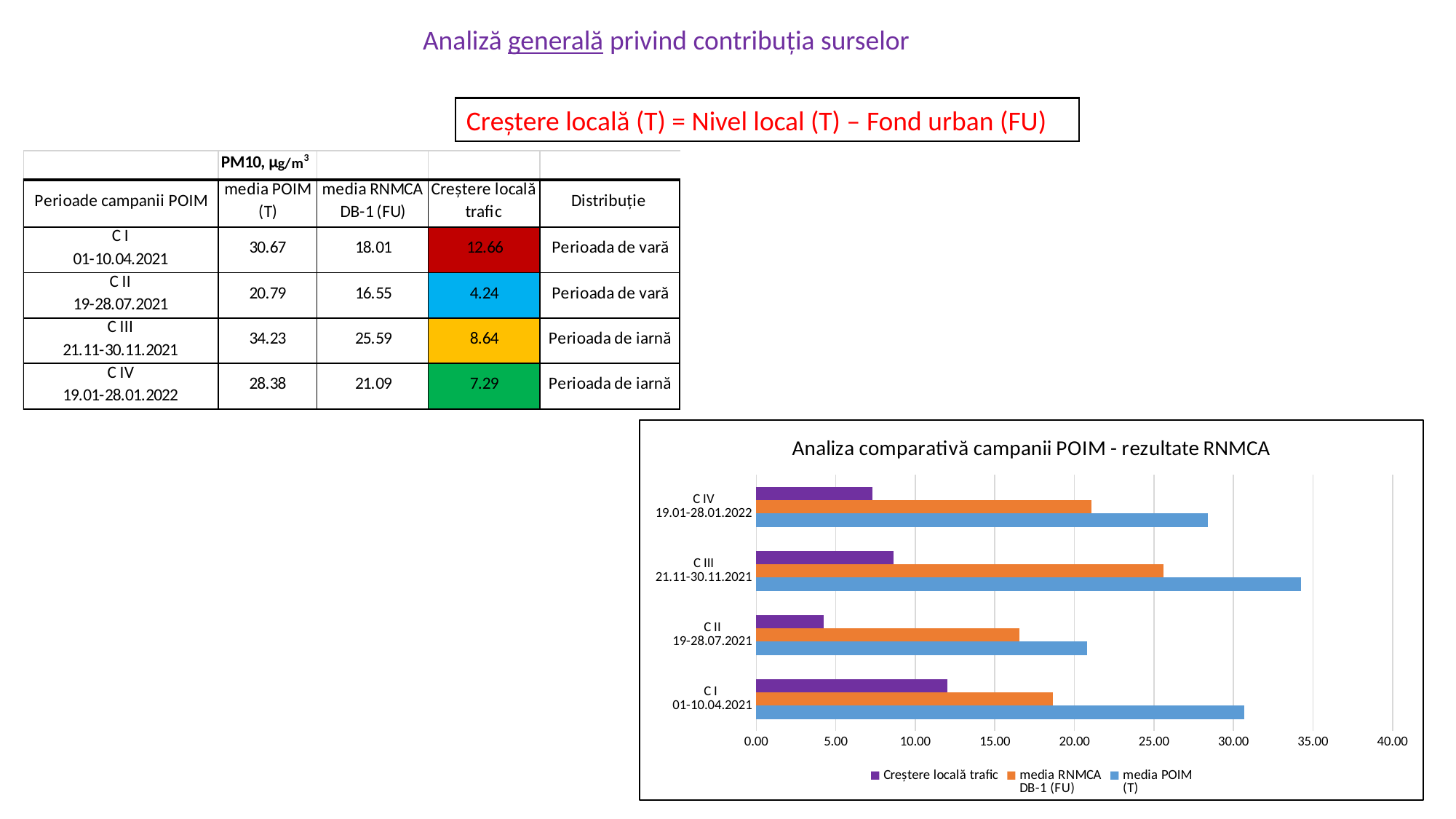
What is the media POIM (T) value for C I 01-10.04.2021? 30.67 Which campaign has the highest media POIM (T) value? C III 21.11-30.11.2021 What is the title of the chart? Analiza comparativă campanii POIM - rezultate RNMCA What kind of chart is shown on the slide? bar chart Which campaign has the lowest Creștere locală trafic value? C II 19-28.07.2021 What colour are the Creștere locală trafic bars in the chart? purple Is the media POIM (T) value for C III 21.11-30.11.2021 greater or less than 30.00? greater How many campaign periods are plotted on the chart? 4 Is the Creștere locală trafic value for C I 01-10.04.2021 greater or less than 10.00? greater How many series does the chart legend list? 3 Which is larger, the media RNMCA DB-1 (FU) value for C III or for C IV? C III What is the difference between media POIM (T) and media RNMCA DB-1 (FU) for C I 01-10.04.2021? 12.66